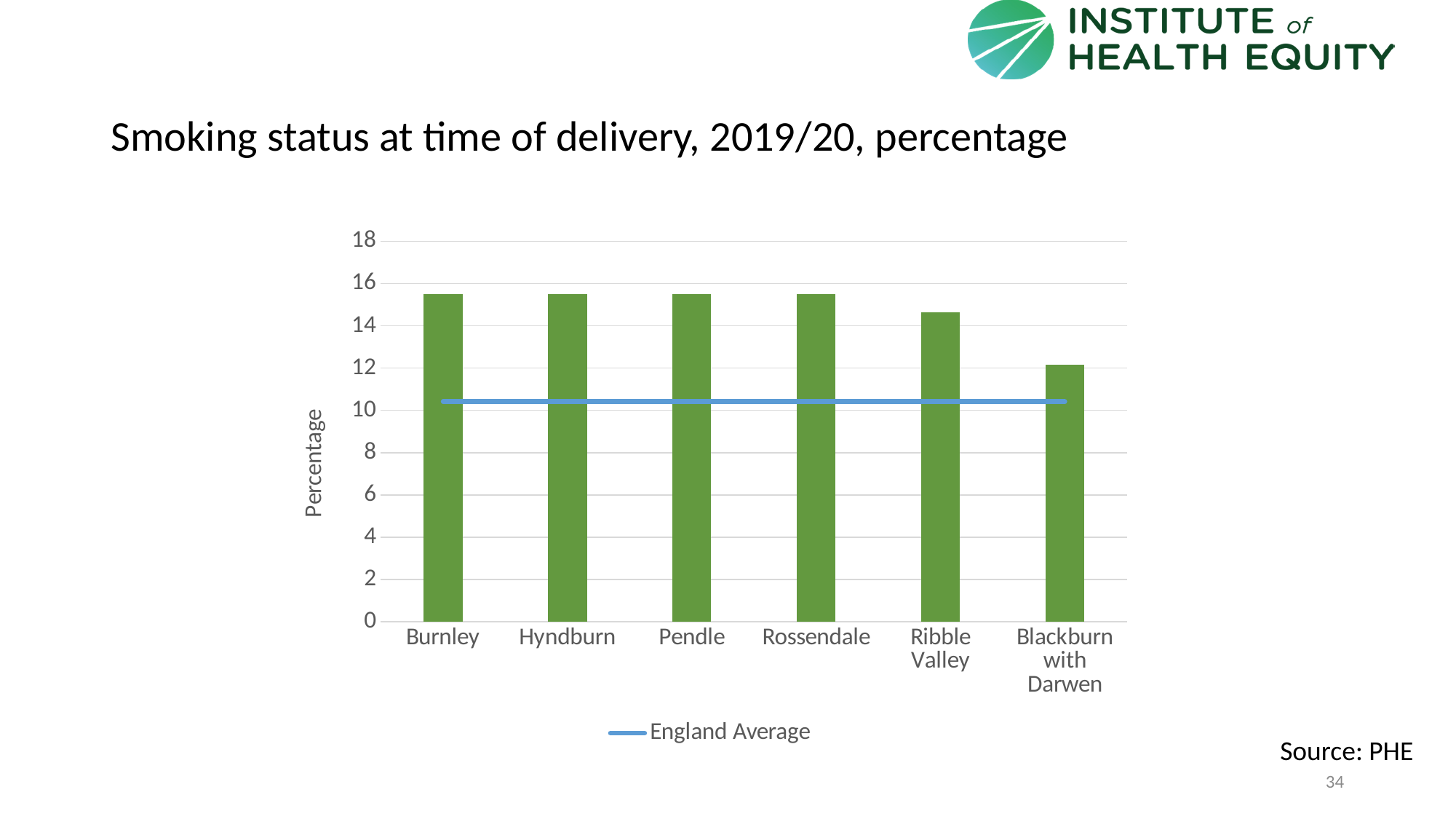
Which is larger, the value for Pendle or the value for Ribble Valley? Pendle Is the England Average line greater or less than 12? less What kind of chart is shown on the slide? Bar chart How many entries does the chart's legend list? 1 Is the value for Ribble Valley greater or less than 12? greater Is the value for Burnley greater or less than 14? greater Do the bar values rise or fall from Rossendale to Blackburn with Darwen along the x axis? fall Which is larger, the value for Ribble Valley or the value for Blackburn with Darwen? Ribble Valley What is the label on the chart's vertical axis? Percentage How many local areas are shown on the x axis of the chart? 6 Which area has the lowest smoking status at time of delivery percentage? Blackburn with Darwen